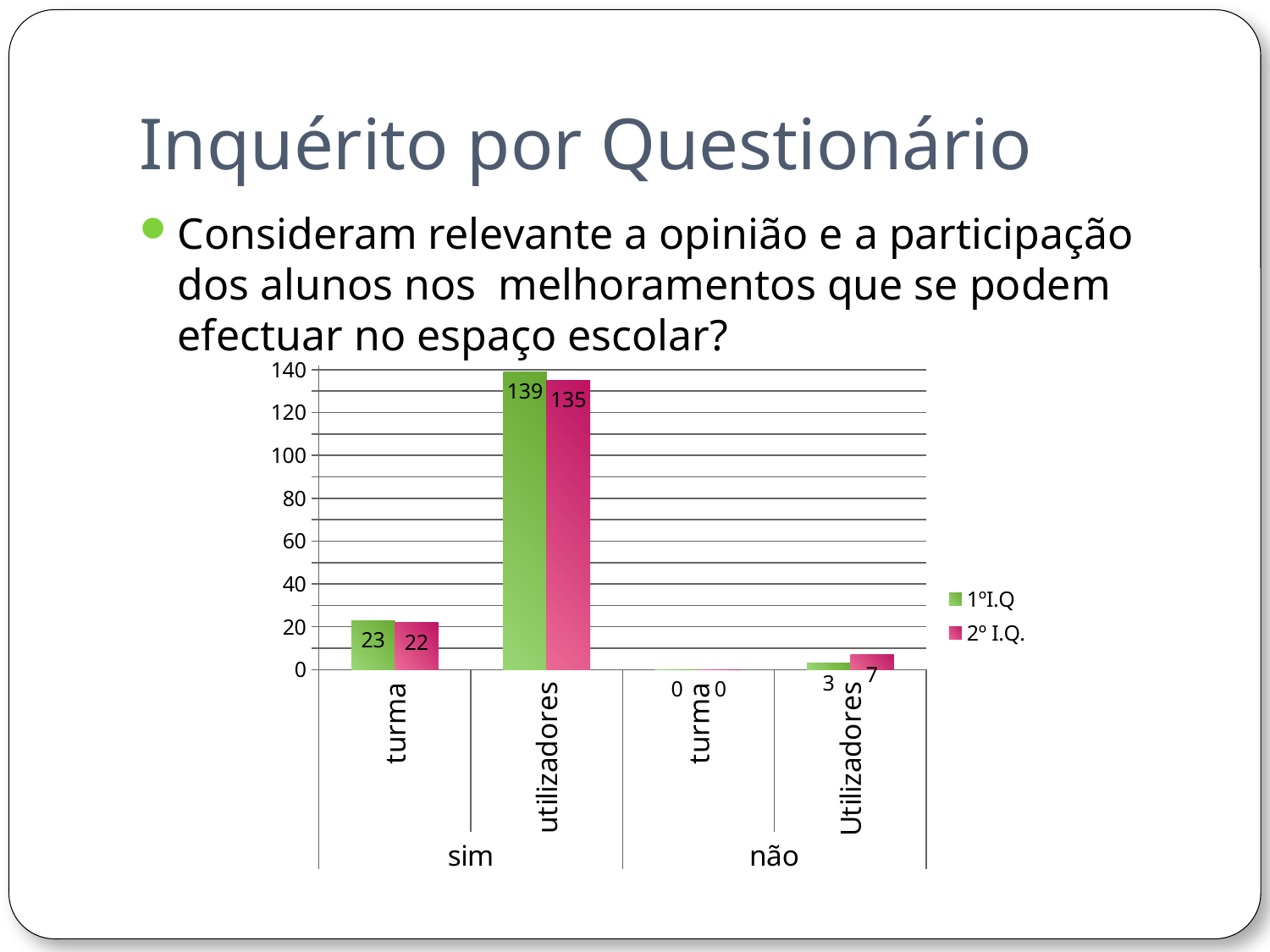
What is the value for 2º I.Q. for 'Utilizadores' under 'não'? 7 How many series does the legend list? 2 Which category has the highest value for 1ºI.Q? utilizadores (sim) What is the value for 1ºI.Q for 'turma' under 'não'? 0 What is the difference between the 1ºI.Q and 2º I.Q. values for 'utilizadores' under 'sim'? 4 What is the difference between the 1ºI.Q values for 'turma' and 'utilizadores' under 'sim'? 116 How many categories are shown on the x axis? 4 For 'Utilizadores' under 'não', which series has the larger value, 1ºI.Q or 2º I.Q.? 2º I.Q. What is the value for 1ºI.Q for 'utilizadores' under 'sim'? 139 What is the value for 2º I.Q. for 'utilizadores' under 'sim'? 135 What kind of chart is shown on the slide? Bar chart What is the value for 1ºI.Q for 'turma' under 'sim'? 23